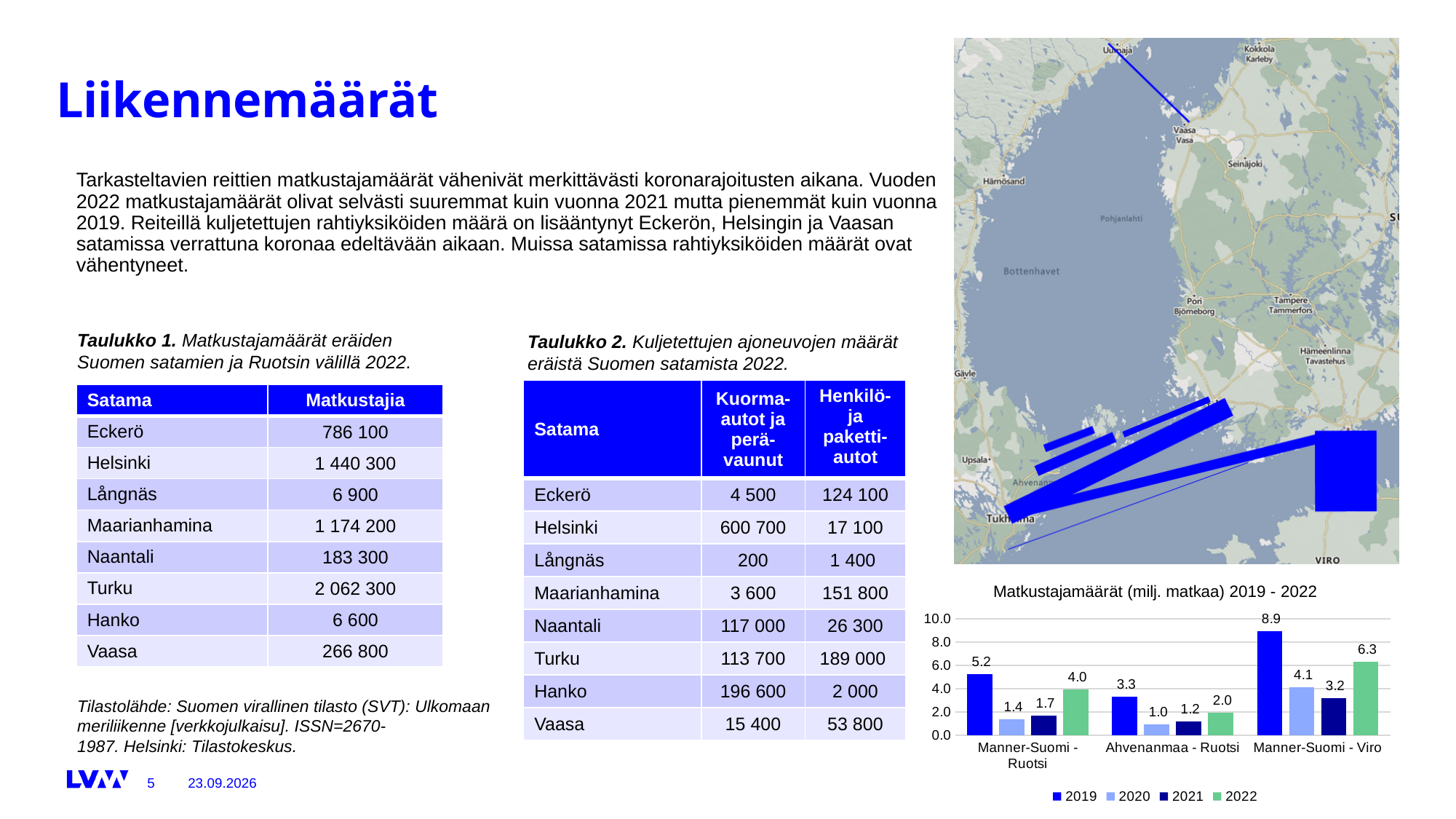
What is the 2019 value for Manner-Suomi - Viro in the chart? 8.9 What is the title of the chart? Matkustajamäärät (milj. matkaa) 2019 - 2022 What is the difference between the 2019 and 2022 values for Manner-Suomi - Viro? 2.6 How many categories are shown on the x axis of the chart? 3 How many series does the chart legend list? 4 What is the 2022 value for Manner-Suomi - Ruotsi in the chart? 4.0 Which is larger for Manner-Suomi - Ruotsi: the 2020 value or the 2021 value? 2021 What kind of chart is shown on the slide? bar chart Which category has the lowest 2022 value in the chart? Ahvenanmaa - Ruotsi Is the 2022 value for Manner-Suomi - Viro greater or less than 6.0? greater Which category has the highest 2019 value in the chart? Manner-Suomi - Viro What is the 2020 value for Ahvenanmaa - Ruotsi in the chart? 1.0